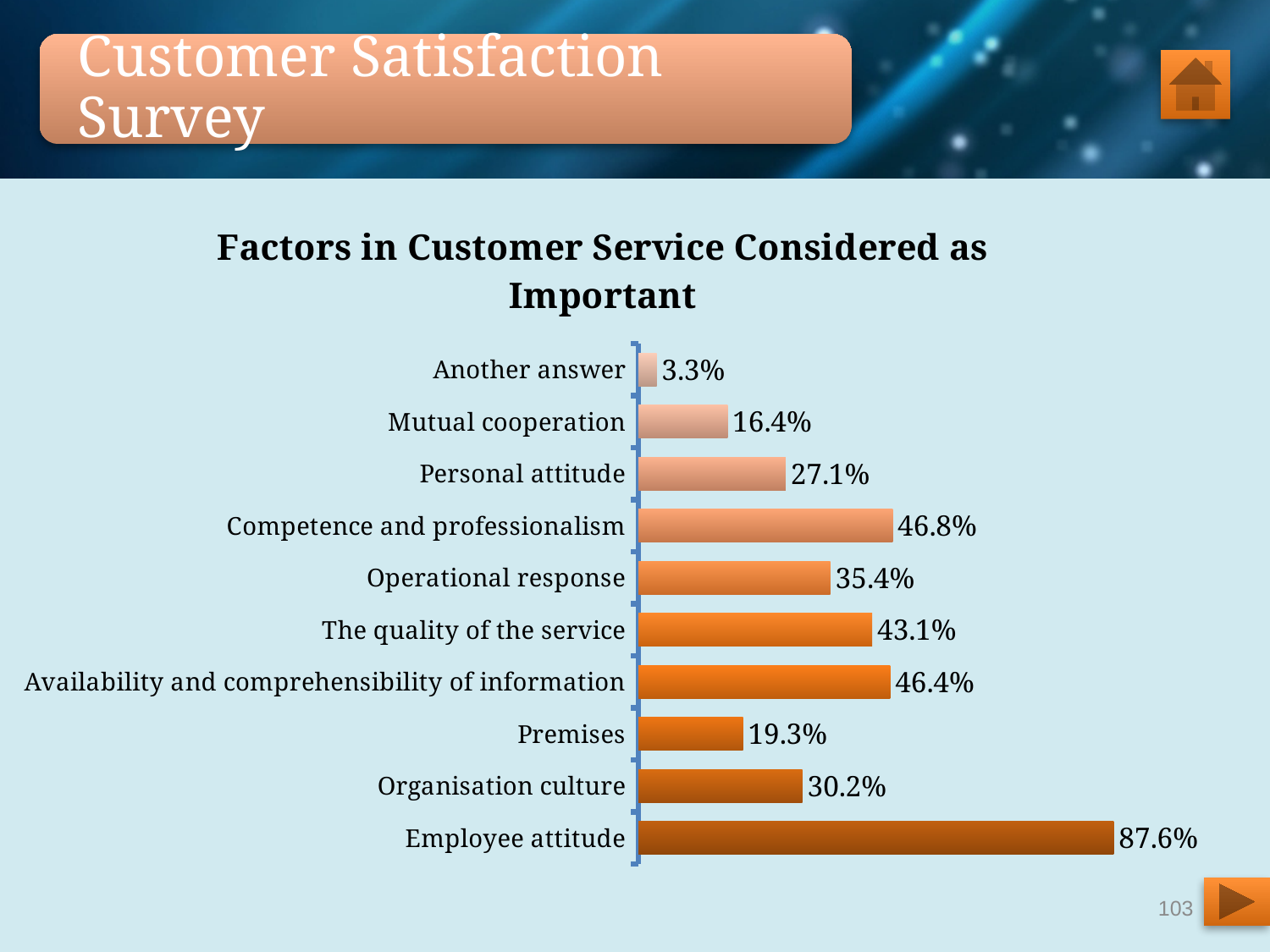
Which category has the lowest value? Another answer What is the value for Employee attitude? 87.6% What is the difference between the values for The quality of the service and Operational response? 7.7% How many categories are shown in the chart? 10 What is the title of the chart? Factors in Customer Service Considered as Important Which is larger, the value for Operational response or the value for The quality of the service? The quality of the service What kind of chart is shown on the slide? Bar chart What is the value for Competence and professionalism? 46.8% What is the difference between the values for Employee attitude and Organisation culture? 57.4% Which is larger, the value for Personal attitude or the value for Mutual cooperation? Personal attitude Which category has the highest value? Employee attitude What is the value for Premises? 19.3%